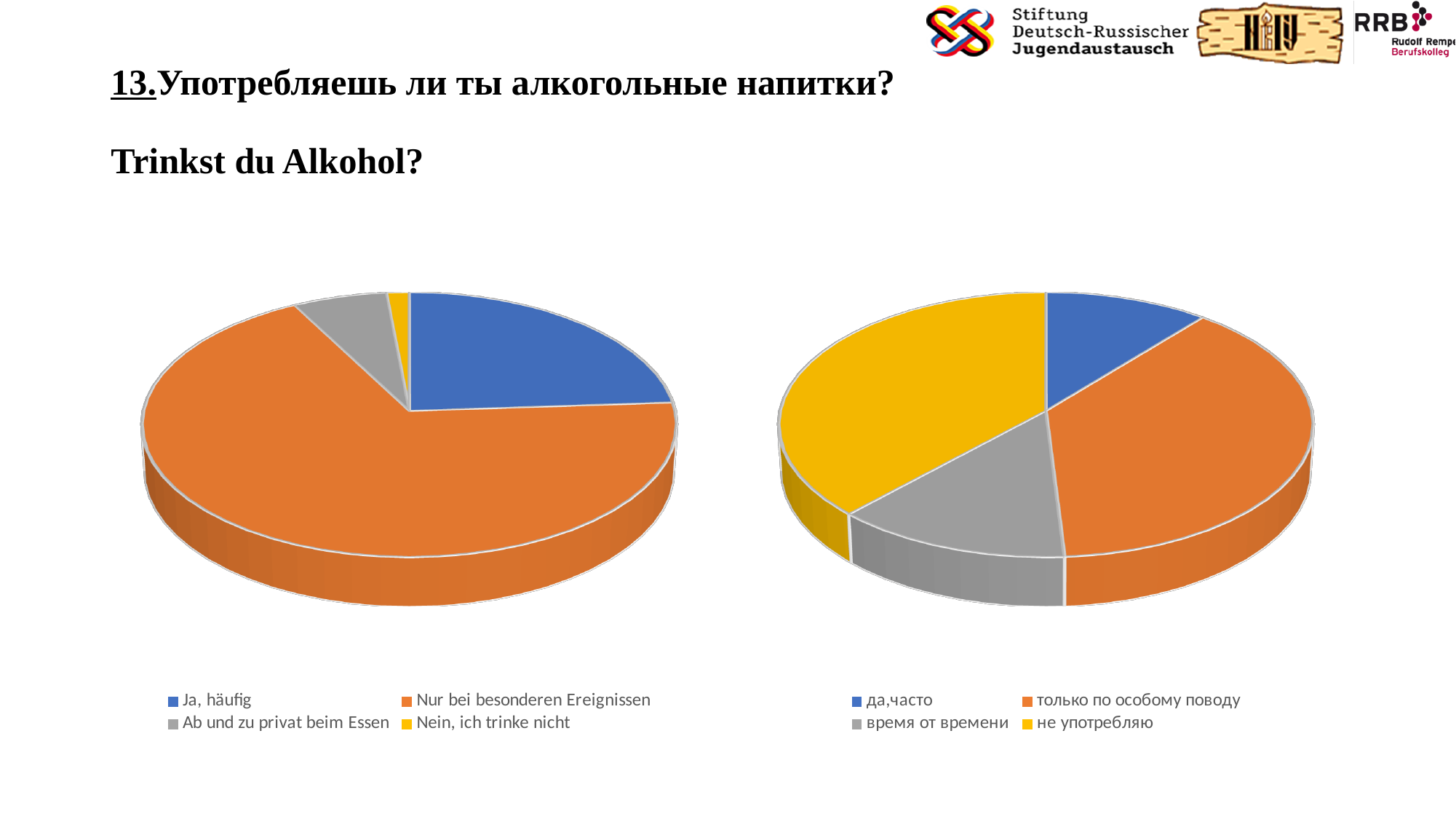
What type of chart is the right chart on the slide? Pie chart How many categories does the legend of the left pie chart list? 4 In the left pie chart, which slice is larger: 'Ja, häufig' or 'Ab und zu privat beim Essen'? Ja, häufig In the left pie chart, what colour is the slice for 'Nein, ich trinke nicht'? Yellow In the right pie chart, which category has the smallest slice? да,часто In the left pie chart, which category has the smallest slice? Nein, ich trinke nicht In the right pie chart, which slice is larger: 'не употребляю' or 'время от времени'? не употребляю In the left pie chart, which category has the largest slice? Nur bei besonderen Ereignissen In the right pie chart, which slice is larger: 'да,часто' or 'время от времени'? время от времени How many categories does the legend of the right pie chart list? 4 What type of chart is the left chart on the slide? Pie chart